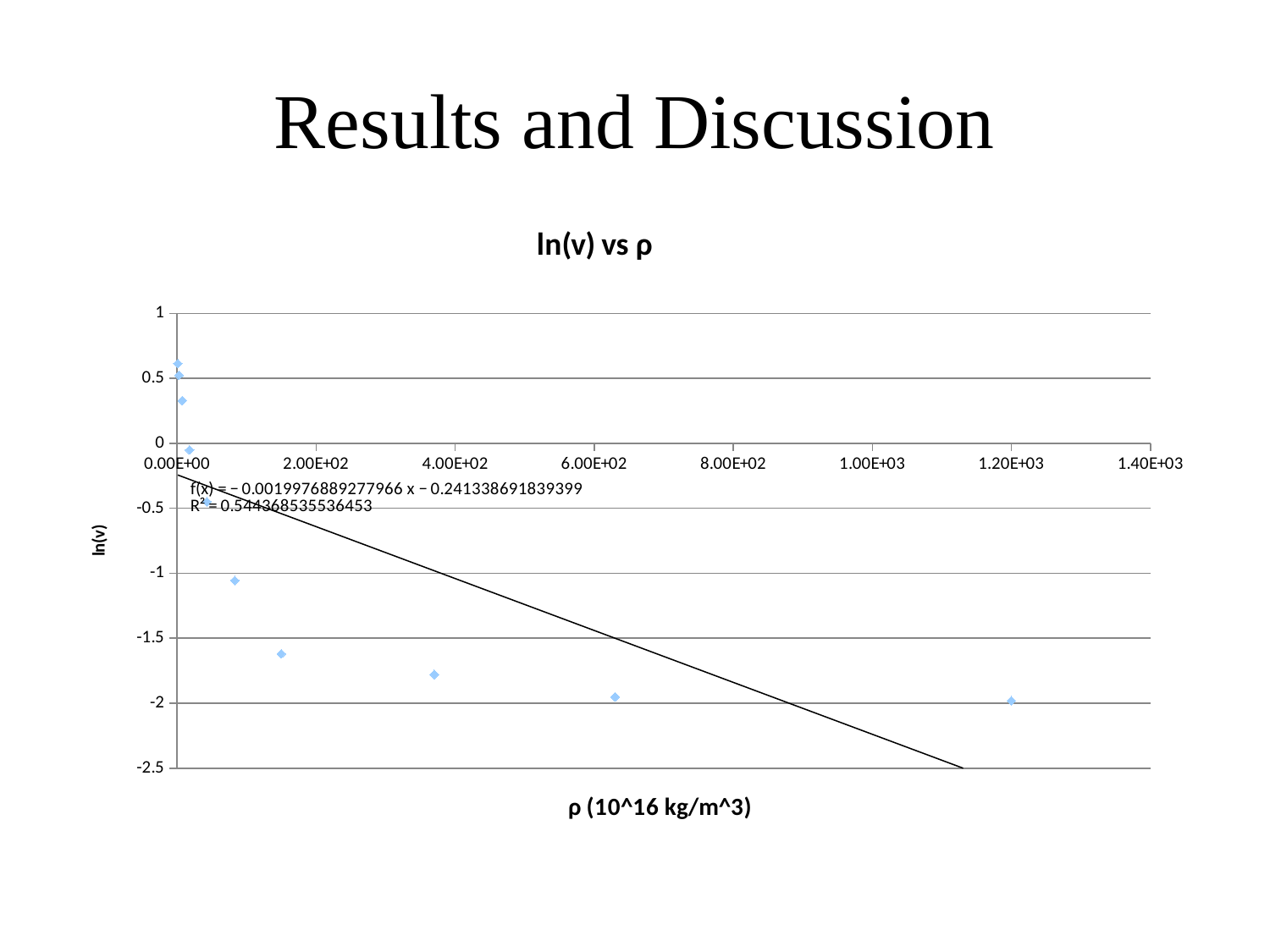
Is the ln(v) value of the point plotted near ρ = 4.00E+02 greater or less than -1? less What kind of chart is shown on the slide? scatter chart Do the ln(v) values generally rise or fall as ρ increases along the x axis? fall Is the highest plotted ln(v) value greater or less than 0? greater What is the title of the chart? ln(v) vs ρ Which has the higher ln(v) value: the point plotted near ρ = 4.00E+02 or the point plotted near ρ = 1.20E+03? the point near ρ = 4.00E+02 Near which ρ value is the point with the highest ln(v) located? 0.00E+00 How many data points are plotted on the chart? 10 Is the ln(v) value of the point plotted near ρ = 6.00E+02 greater or less than -1.5? less What R² value is printed on the chart? 0.544368535536453